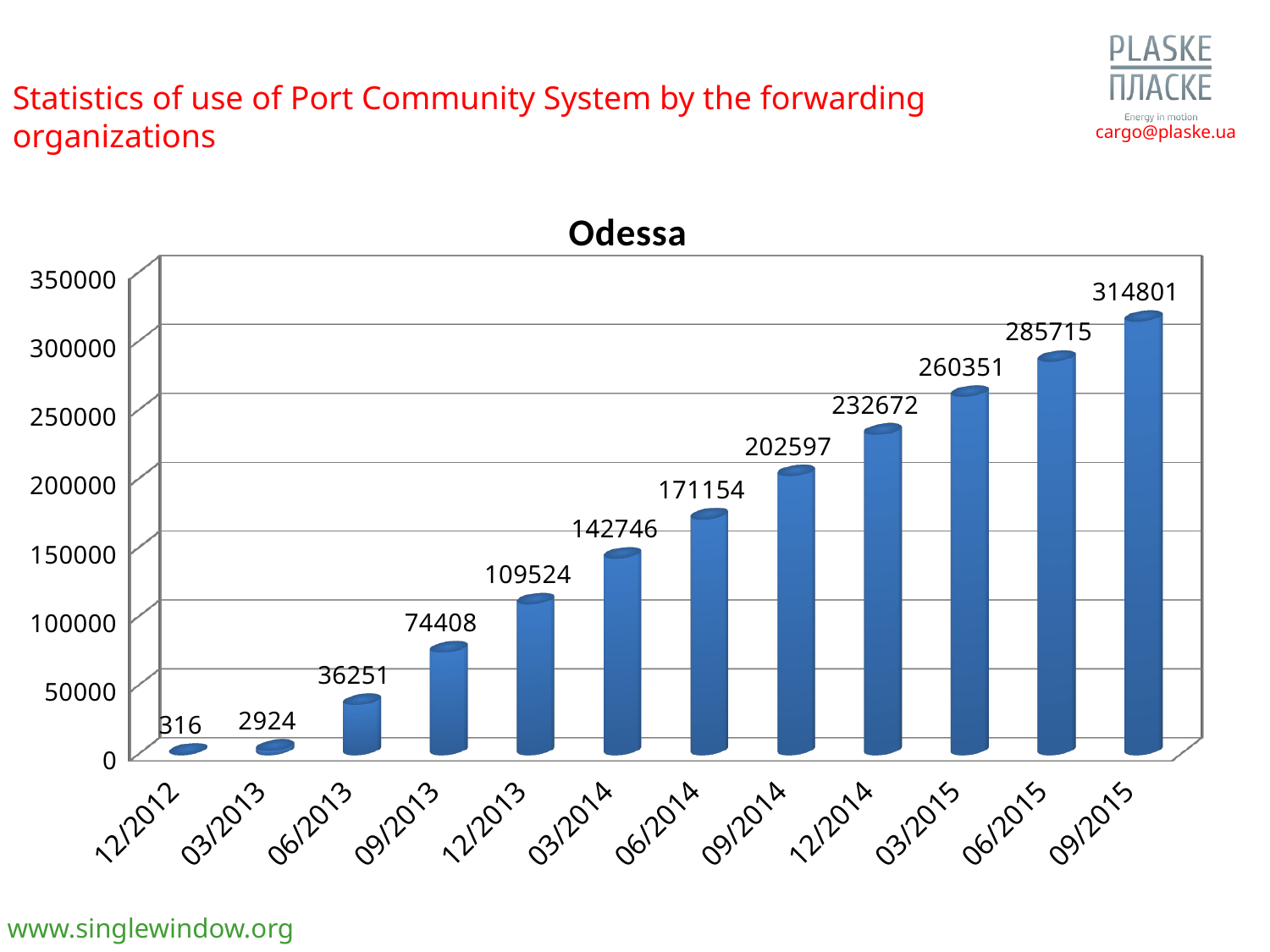
Which period has the lowest value in the Odessa chart? 12/2012 Is the value for 12/2014 greater or less than 200000? greater Do the values rise or fall from 12/2012 to 09/2015? rise What is the difference between the values for 09/2015 and 06/2015? 29086 What is the value for 03/2013 in the Odessa chart? 2924 Which is larger, the value for 09/2013 or the value for 06/2013? 09/2013 What is the value for 09/2015 in the Odessa chart? 314801 What is the difference between the values for 09/2014 and 06/2014? 31443 What is the value for 12/2013 in the Odessa chart? 109524 Which period has the highest value in the Odessa chart? 09/2015 How many periods are shown on the x axis of the Odessa chart? 12 What kind of chart is shown on the slide? bar chart